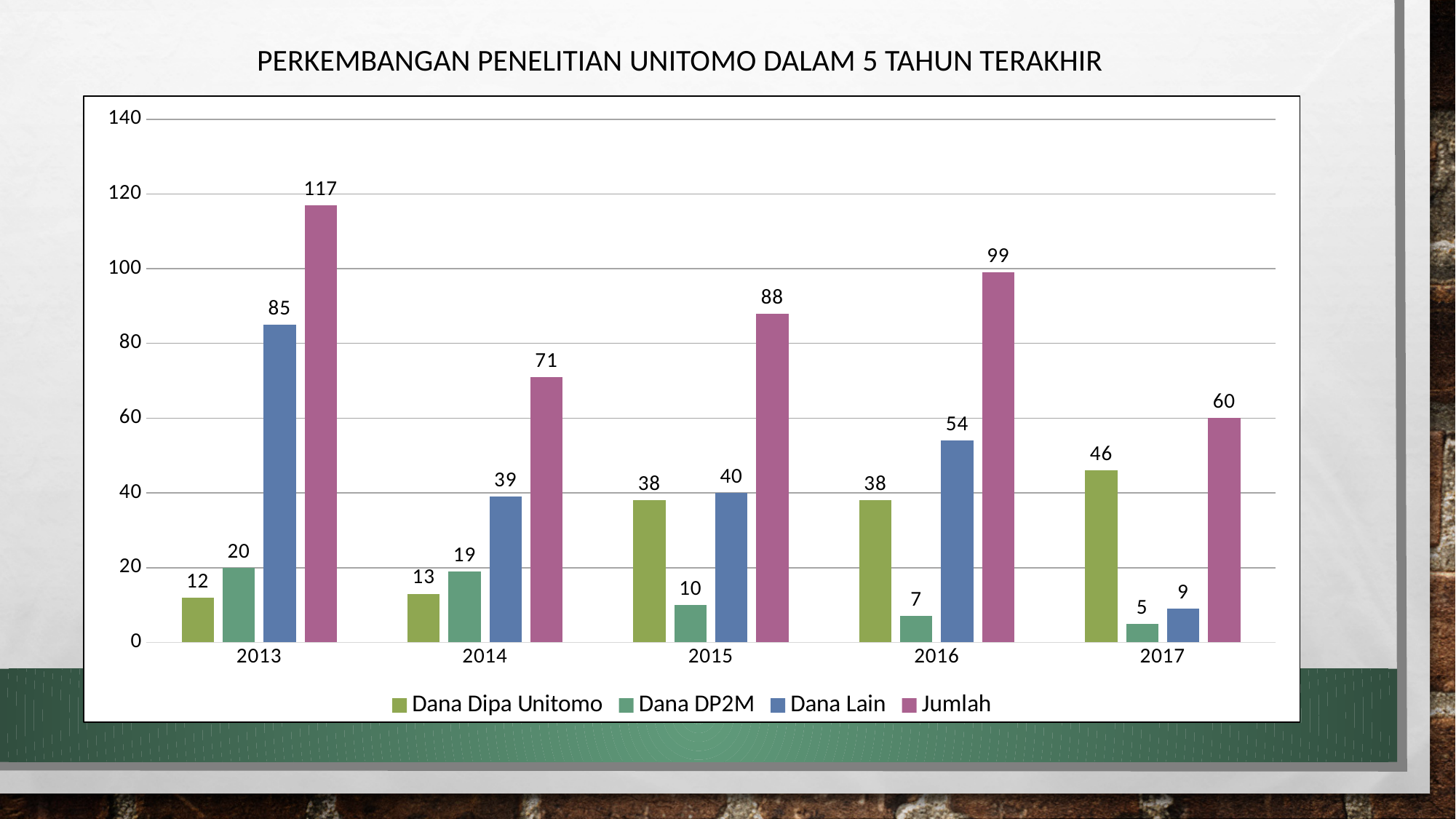
Which is larger in 2015: Dana Dipa Unitomo or Dana Lain? Dana Lain Is the Jumlah value for 2014 greater or less than 80? less In which year is the Jumlah value highest? 2013 What kind of chart is shown on the slide? bar chart What is the Jumlah value for 2016? 99 In which year is the Dana DP2M value lowest? 2017 Does the Dana Dipa Unitomo value rise or fall from 2013 to 2017? rise How many years are shown on the x axis? 5 What is the difference between the Jumlah values for 2013 and 2017? 57 What is the value of Dana Lain in 2013? 85 How many series does the legend list? 4 What is the value of Dana DP2M in 2017? 5